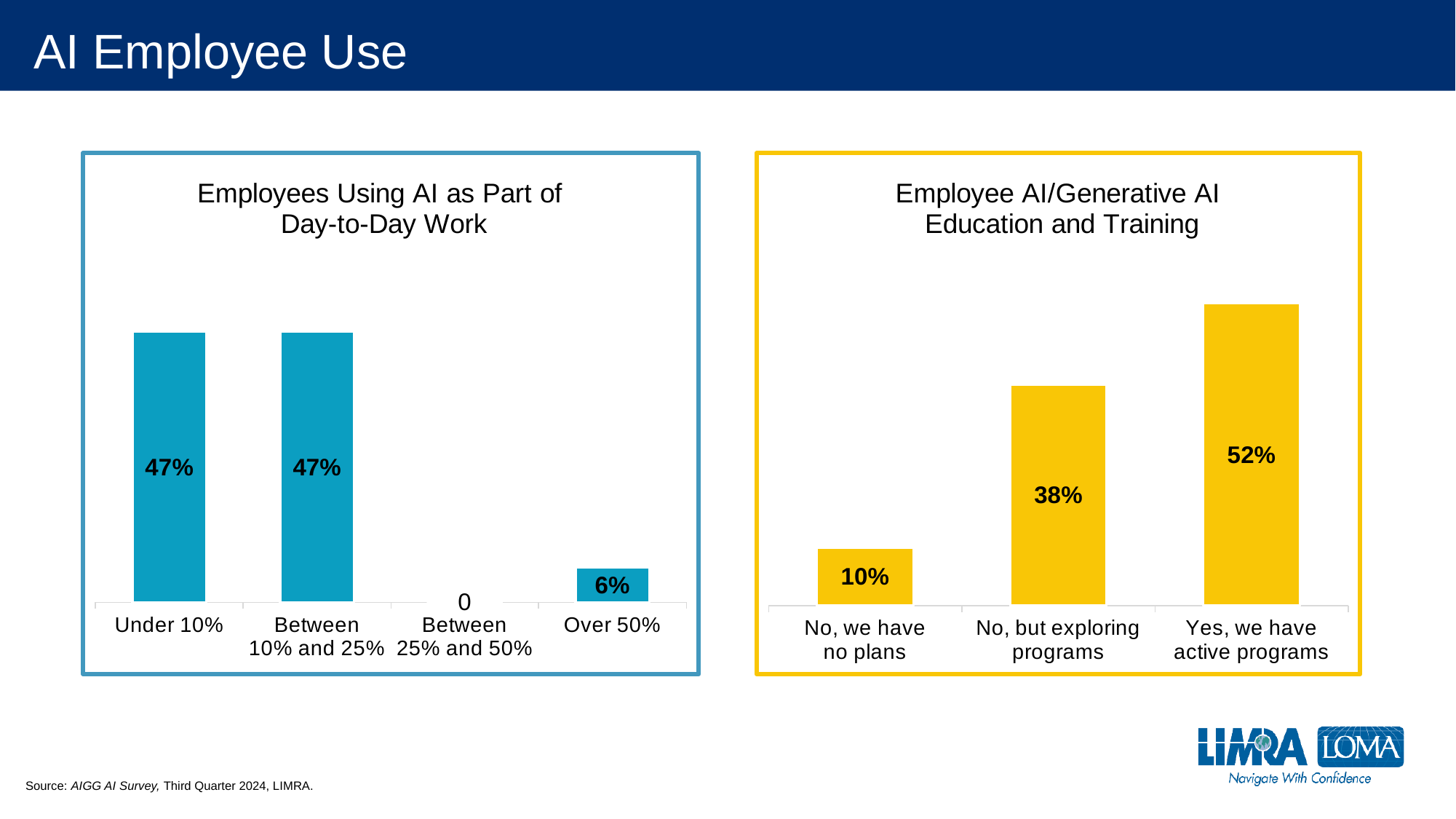
In the 'Employees Using AI as Part of Day-to-Day Work' chart, what is the difference between 'Between 10% and 25%' and 'Over 50%'? 41% In the 'Employee AI/Generative AI Education and Training' chart, how many categories are shown? 3 What type of chart is the 'Employee AI/Generative AI Education and Training' chart? Bar chart In the 'Employees Using AI as Part of Day-to-Day Work' chart, what is the value for 'Under 10%'? 47% In the 'Employees Using AI as Part of Day-to-Day Work' chart, what is the value for 'Over 50%'? 6% In the 'Employee AI/Generative AI Education and Training' chart, what is the value for 'No, but exploring programs'? 38% In the 'Employee AI/Generative AI Education and Training' chart, which category has the lowest value? No, we have no plans In the 'Employees Using AI as Part of Day-to-Day Work' chart, which category has the lowest value? Between 25% and 50% In the 'Employees Using AI as Part of Day-to-Day Work' chart, what is the value for 'Between 25% and 50%'? 0 In the 'Employee AI/Generative AI Education and Training' chart, which category has the highest value? Yes, we have active programs In the 'Employees Using AI as Part of Day-to-Day Work' chart, how many categories are shown? 4 In the 'Employee AI/Generative AI Education and Training' chart, what is the difference between 'Yes, we have active programs' and 'No, we have no plans'? 42%